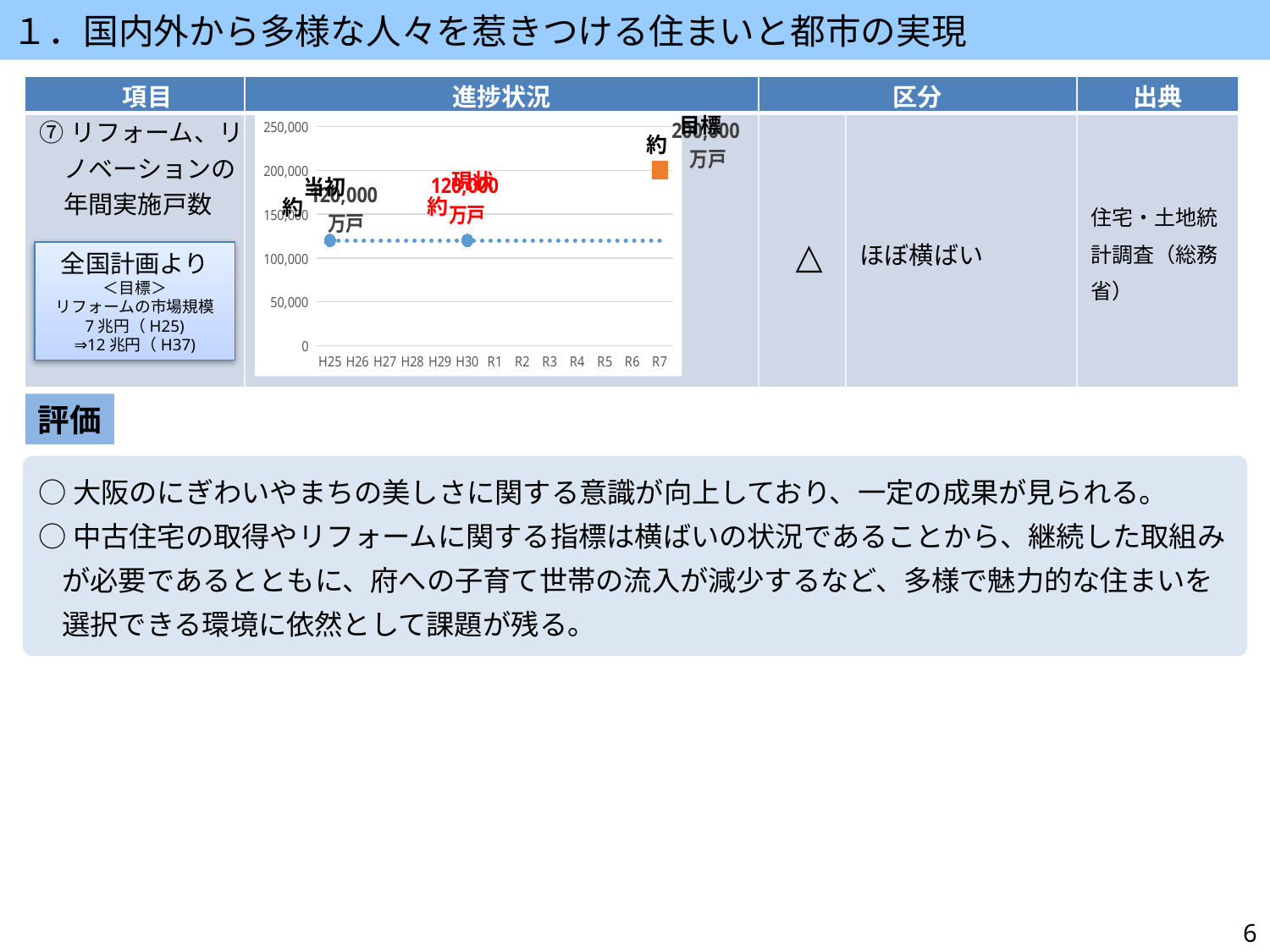
Does the dotted line rise, fall, or stay flat between H25 and H30? stays flat Is the plotted value for H30 greater or less than 150,000? less Is the target (目標) marker at R7 greater or less than 150,000? greater What kind of chart is shown in the 進捗状況 column? line chart What is the first category on the x axis of the chart? H25 What is the highest value shown on the y axis of the chart? 250,000 Is the target (目標) marker at R7 greater or less than 250,000? less Which is larger, the target marker at R7 or the plotted value at H30? the target marker at R7 What is the last category on the x axis of the chart? R7 How many categories are shown on the x axis of the chart? 13 What is the data label printed for the H25 point? 120,000万戸